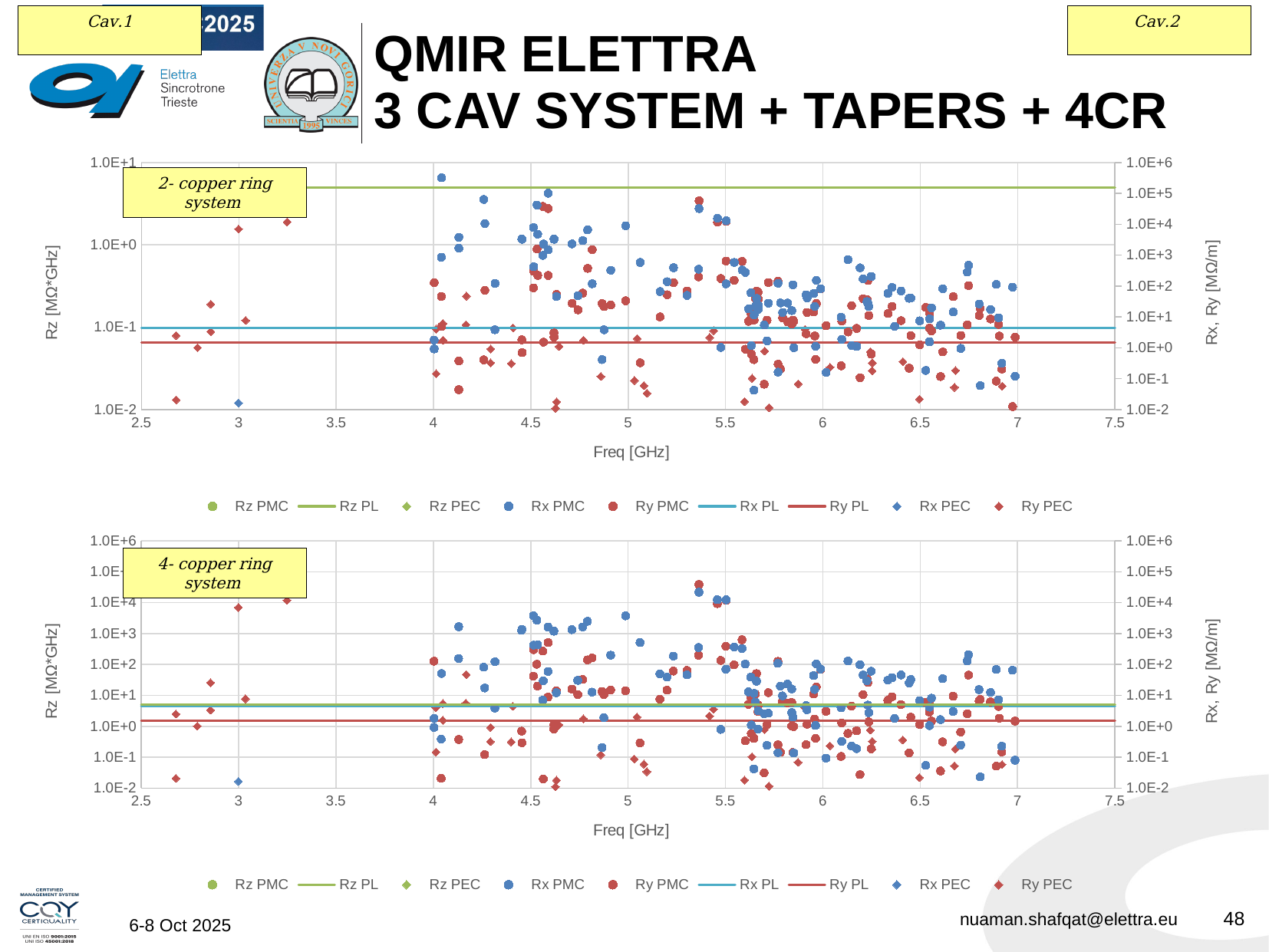
In the "4- copper ring system" chart, what is the lowest tick value shown on the x axis? 2.5 What kind of chart is the top chart labelled "2- copper ring system"? scatter chart How many series does the legend of the "4- copper ring system" chart list? 9 What is the x-axis label of the "4- copper ring system" chart? Freq [GHz] In the "4- copper ring system" chart, is the Rx PL line greater or less than 1.0E+3 on the right axis? less What is the left y-axis label of the "2- copper ring system" chart? Rz [MΩ*GHz] In the "2- copper ring system" chart, is the Ry PL line greater or less than 1.0E+2 on the right axis? less In the "4- copper ring system" chart, is the Rz PL line greater or less than 1.0E+2 on the left axis? less In the "2- copper ring system" chart, what is the highest tick value shown on the x axis? 7.5 How many charts are shown on the slide? 2 How many series does the legend of the "2- copper ring system" chart list? 9